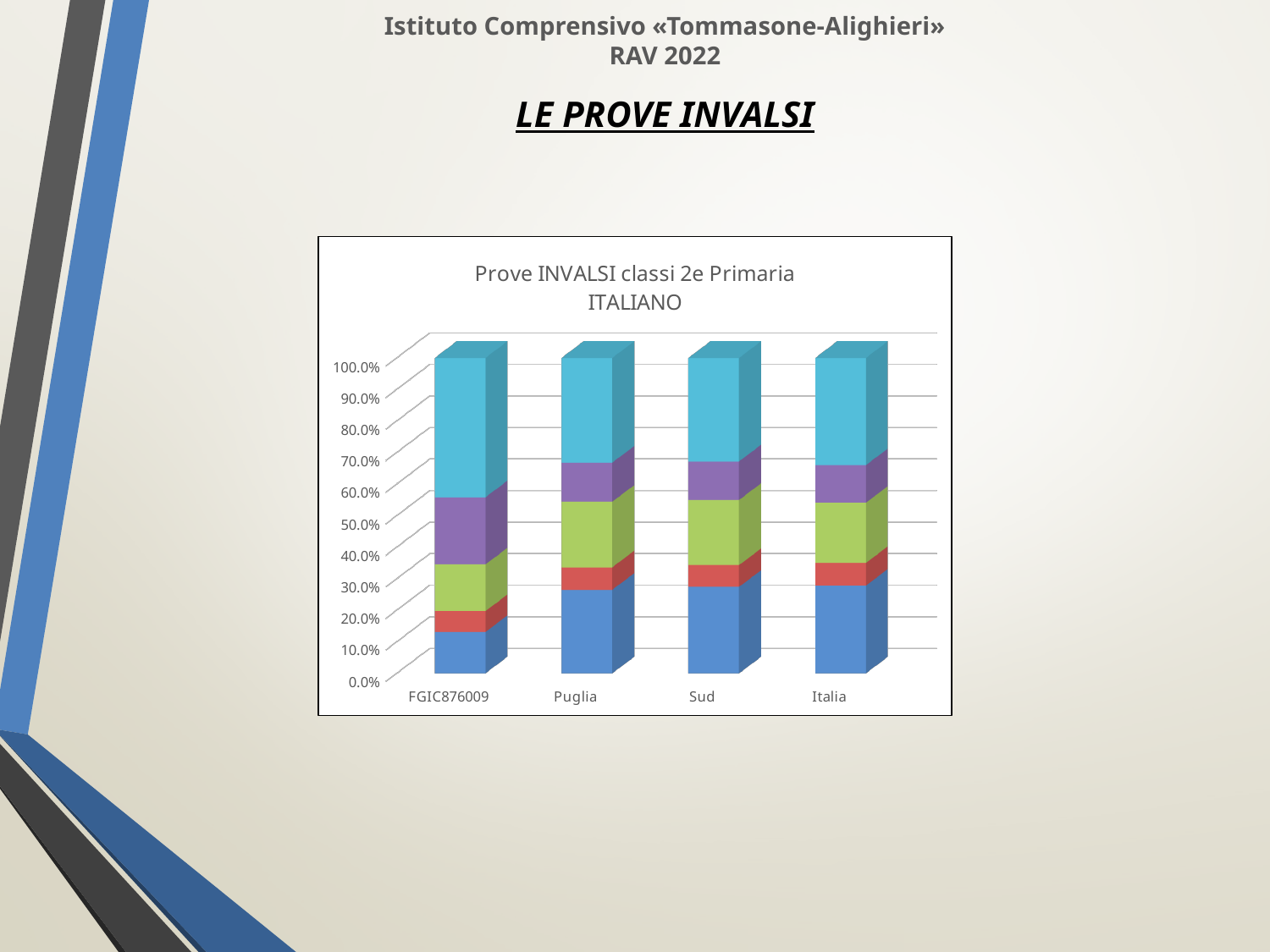
What kind of chart is shown on the slide? Stacked bar chart How many categories are shown on the x axis of the chart? 4 What is the total height of the FGIC876009 bar, as read from the y axis? 100.0% Which category has the largest top (light blue) segment? FGIC876009 Is the top of the bottom (blue) segment for Sud greater or less than 20%? greater Which has a larger bottom (blue) segment, FGIC876009 or Italia? Italia Is the top of the bottom (blue) segment for FGIC876009 greater or less than 20%? less What is the highest value labelled on the y axis? 100.0% What is the title of the chart? Prove INVALSI classi 2e Primaria ITALIANO Which category has the smallest bottom (blue) segment? FGIC876009 What is the total height of the Puglia bar, as read from the y axis? 100.0% Which category is plotted first (leftmost) on the x axis? FGIC876009